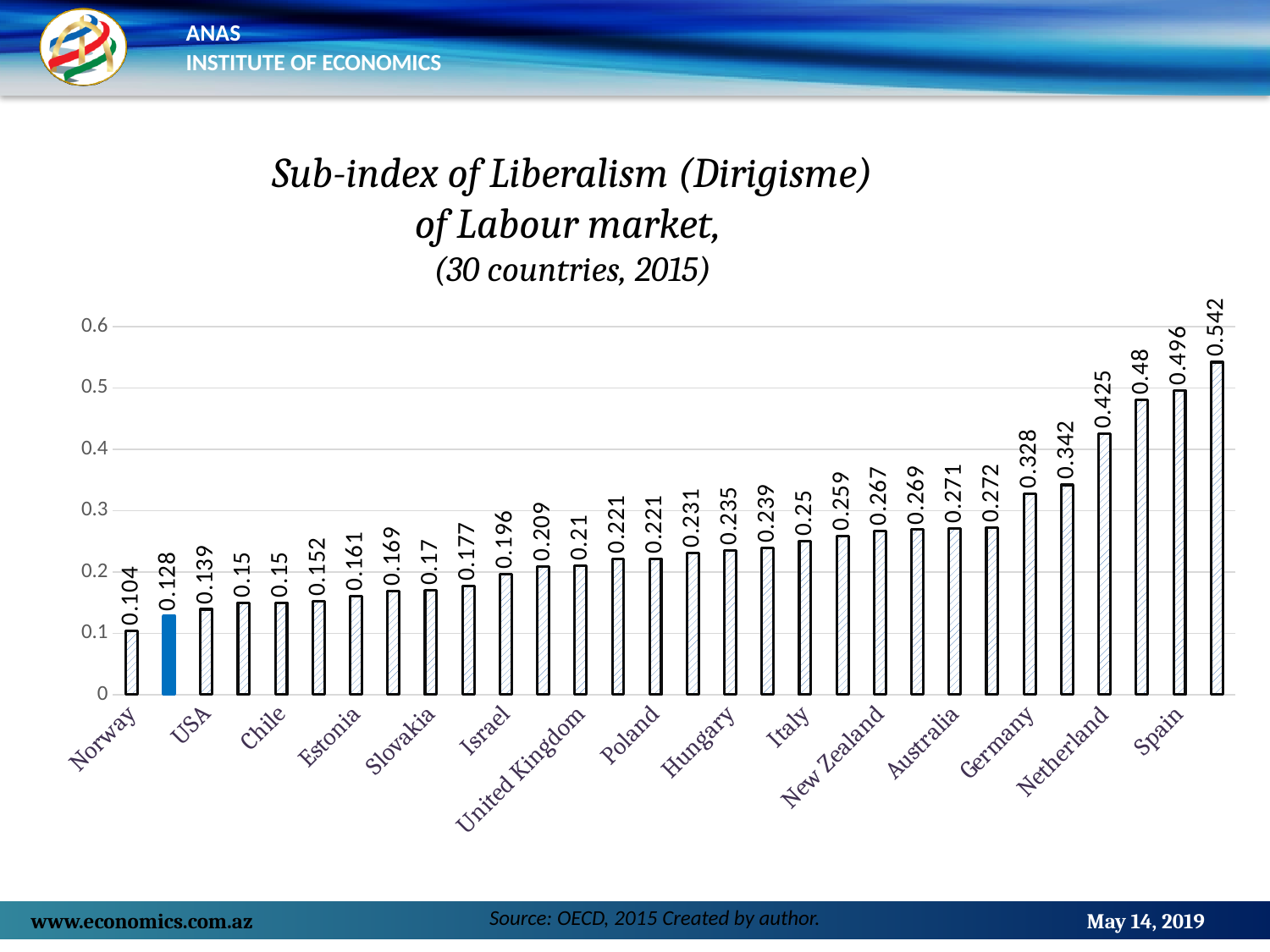
Which has a larger sub-index value, Norway or Spain? Spain What is the sub-index value for Netherland? 0.425 What is the difference between the values for Spain and Norway? 0.392 What is the sub-index value for Norway? 0.104 What type of chart is shown on the slide? bar chart What is the highest value shown on the chart? 0.542 How many bars (countries) are plotted on the chart? 30 Which country has the lowest sub-index value? Norway Do the values rise or fall from left to right along the x axis? rise Is the value for Germany greater or less than 0.3? greater What is the sub-index value for Germany? 0.328 What is the sub-index value for Spain? 0.496